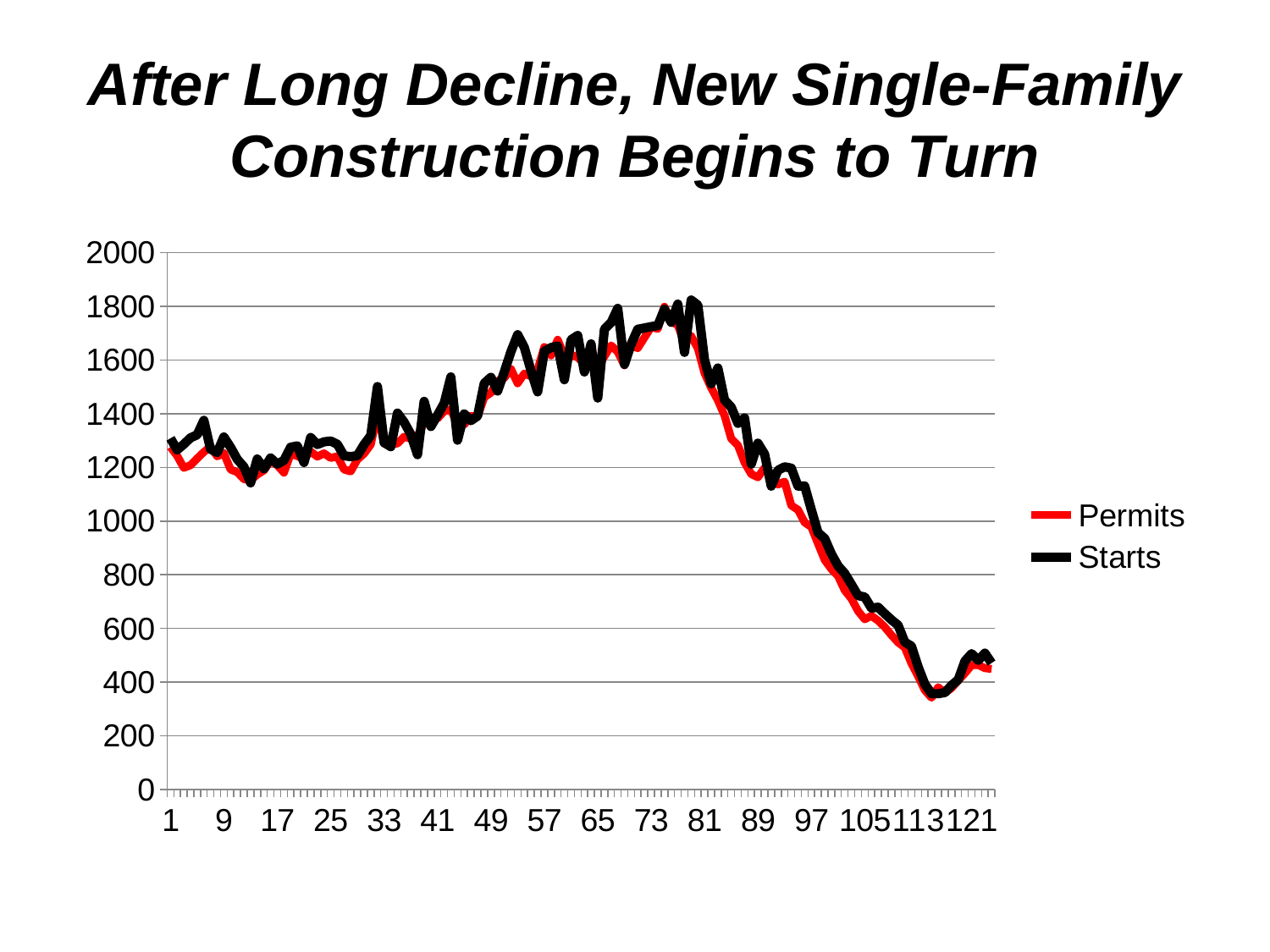
Is the value for Starts at point 105 greater or less than 1000? less Is the value for Permits at point 113 greater or less than 600? less What is the title of the chart on the slide? After Long Decline, New Single-Family Construction Begins to Turn Do the Starts values rise or fall between point 33 and point 73? rise Do the Permits values rise or fall between point 81 and point 113? fall What kind of chart is shown on the slide? line chart Is the value for Permits at point 121 greater or less than 800? less How many series does the legend list? 2 Which colour is used for the Starts series? black